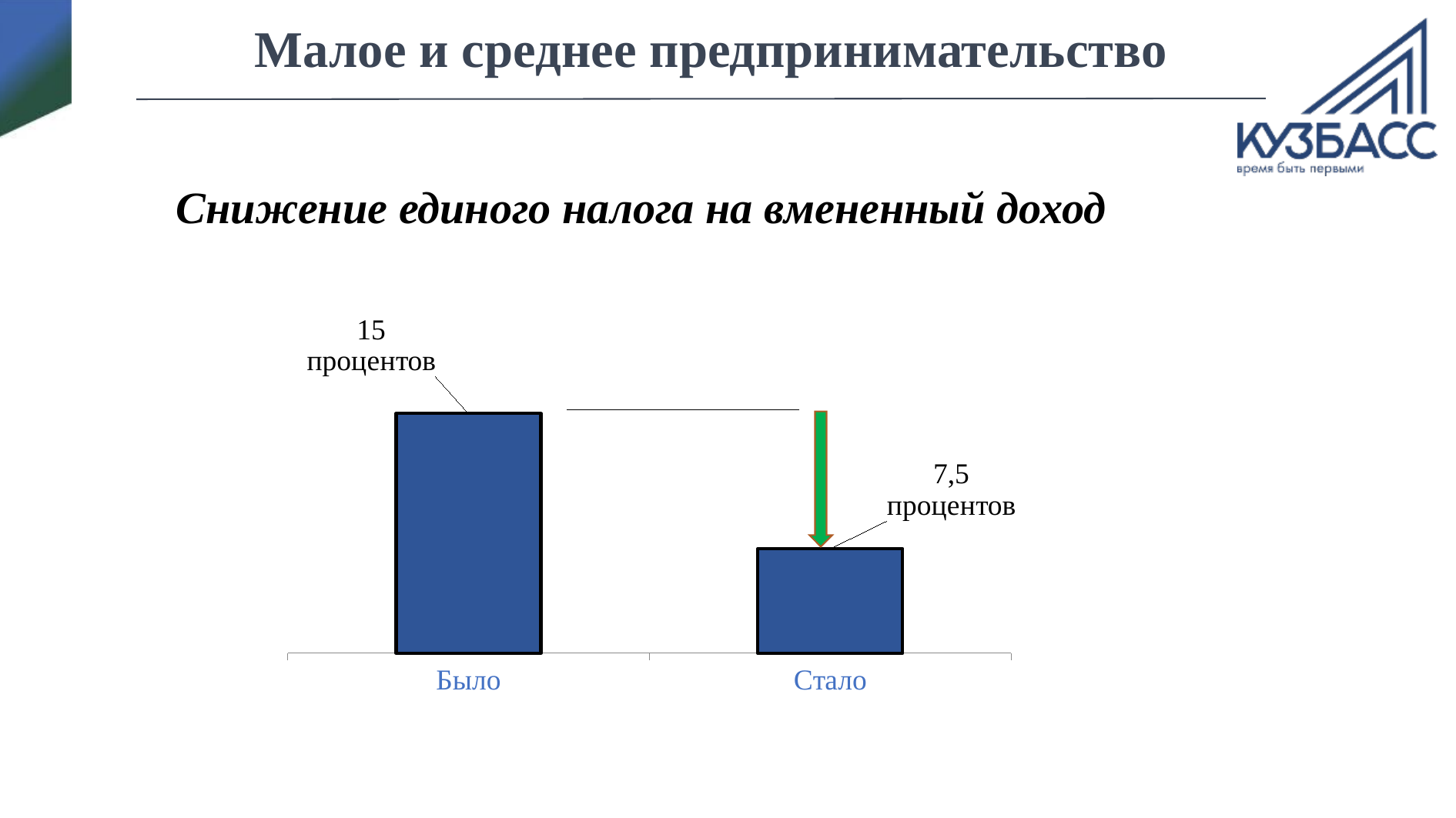
What colour are the bars in the chart? Blue What is the heading above the chart? Снижение единого налога на вмененный доход What is the difference between the values for "Было" and "Стало"? 7,5 процентов How many categories are shown on the x axis? 2 Which category has the lowest value? Стало What is the value for "Было"? 15 процентов What is the value for "Стало"? 7,5 процентов Which category has the higher value, "Было" or "Стало"? Было What kind of chart is shown on the slide? Bar chart Do the values rise or fall from "Было" to "Стало"? Fall Which category has the highest value? Было